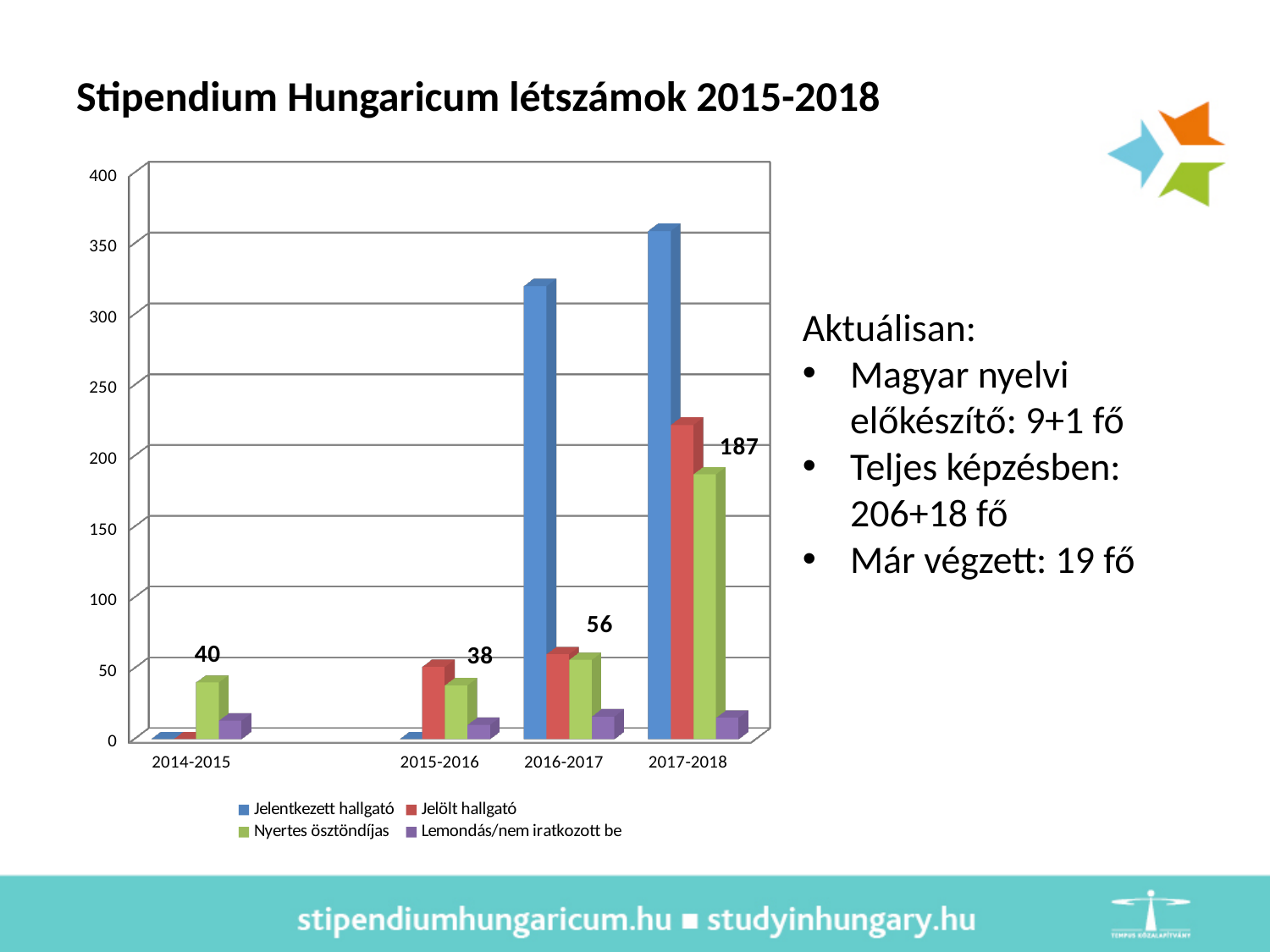
In which academic year is the Nyertes ösztöndíjas value highest? 2017-2018 Is the value for Jelölt hallgató in 2017-2018 greater or less than 150? greater How many series does the legend list? 4 In which academic year is the Nyertes ösztöndíjas value lowest? 2015-2016 What kind of chart is shown on the slide? bar chart Which year has the larger Nyertes ösztöndíjas value, 2014-2015 or 2015-2016? 2014-2015 What is the value for Nyertes ösztöndíjas in 2014-2015? 40 What is the difference between the Nyertes ösztöndíjas values for 2017-2018 and 2016-2017? 131 Is the value for Jelentkezett hallgató in 2017-2018 greater or less than 300? greater What is the value for Nyertes ösztöndíjas in 2016-2017? 56 What is the value for Nyertes ösztöndíjas in 2017-2018? 187 How many academic years are shown on the x axis? 4